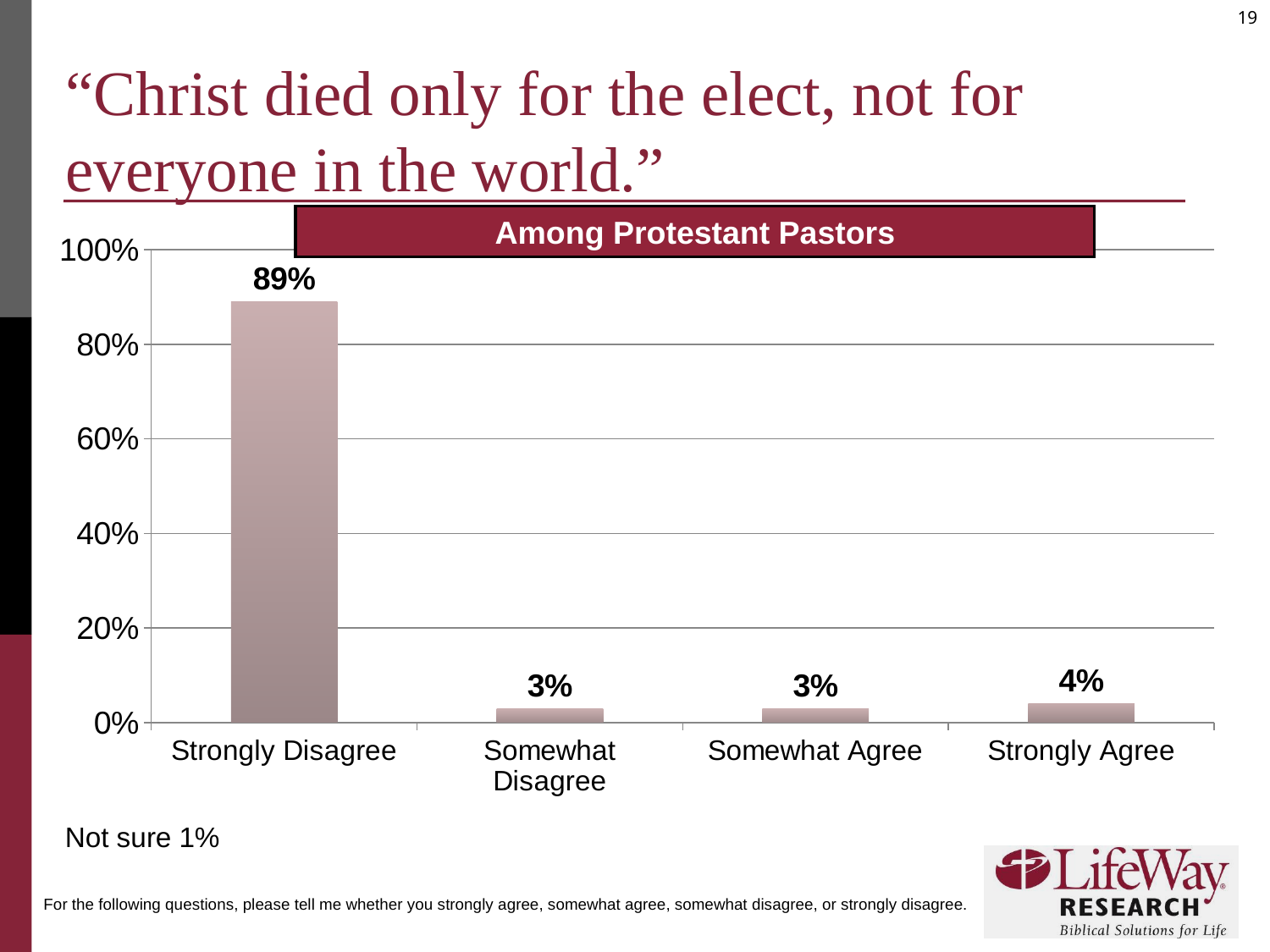
What is the value for Somewhat Disagree? 3% How many response categories are shown on the x axis? 4 What is the value for Strongly Agree? 4% What group does the chart's label say the results are among? Protestant Pastors Which response category has the highest value? Strongly Disagree What is the combined value of Somewhat Agree and Strongly Agree? 7% Is the value for Strongly Disagree greater or less than 80%? greater What percentage of respondents were Not sure, according to the note below the chart? 1% What is the difference between the Strongly Disagree and Strongly Agree values? 85% What percentage of Protestant pastors strongly disagree that Christ died only for the elect? 89% Which is larger, the value for Strongly Agree or the value for Somewhat Agree? Strongly Agree What kind of chart is shown on the slide? bar chart